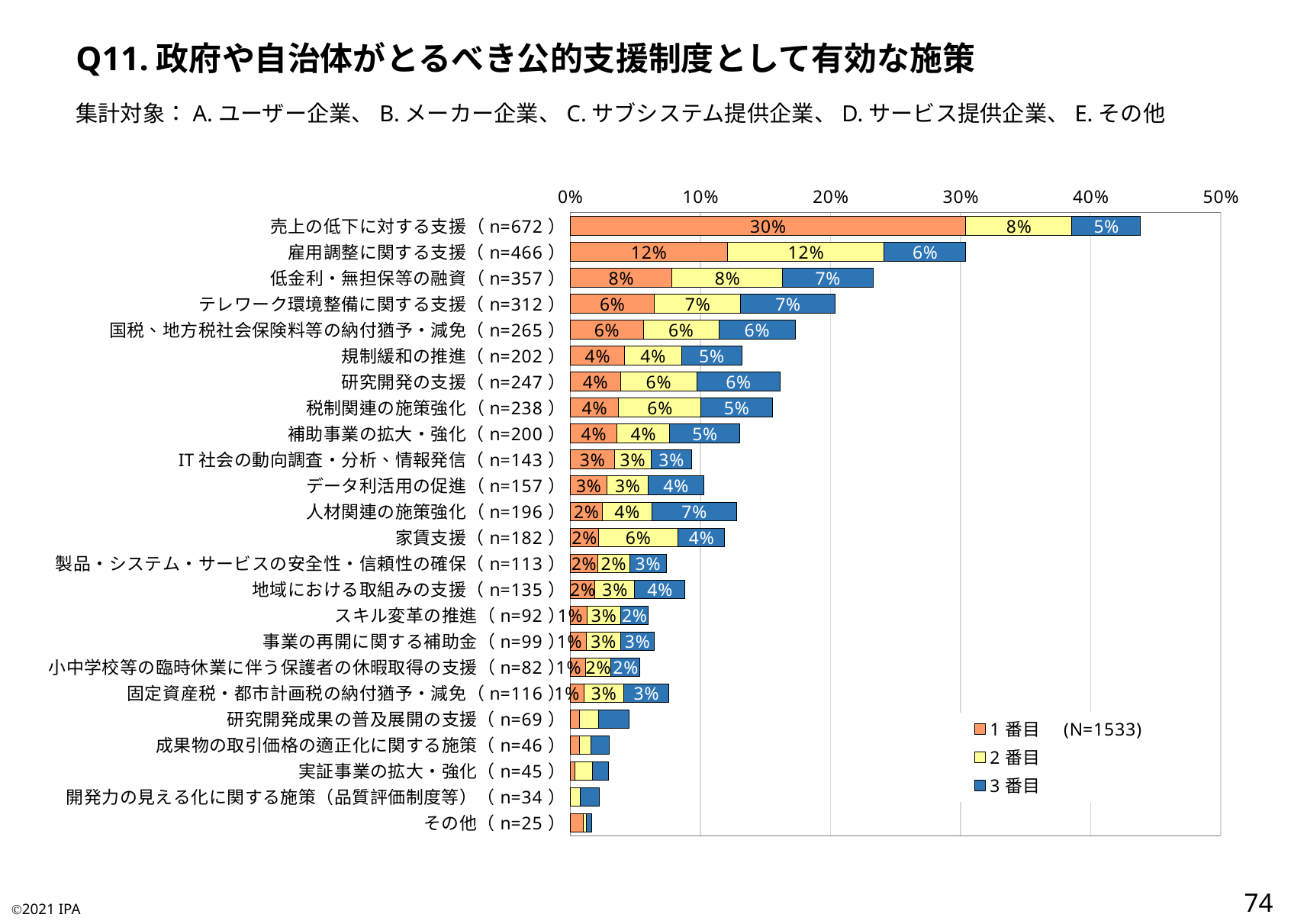
What is the total of the stacked bar for 雇用調整に関する支援 (sum of the three labelled values)? 30% What is the 2番目 value for 家賃支援? 6% Which is larger: the 3番目 value for 人材関連の施策強化 or the 3番目 value for データ利活用の促進? 人材関連の施策強化 How many categories (support measures) are plotted on the chart? 24 What is the 3番目 value for 低金利・無担保等の融資? 7% Which category has the highest 1番目 value? 売上の低下に対する支援 Is the total stacked bar for 売上の低下に対する支援 greater or less than 40%? greater What kind of chart is shown on the slide? Stacked bar chart What sample size (N) is shown next to the legend? N=1533 What is the difference between the 1番目 values for 売上の低下に対する支援 and 雇用調整に関する支援? 18 percentage points What is the 1番目 value for 売上の低下に対する支援? 30% How many series does the legend list? 3